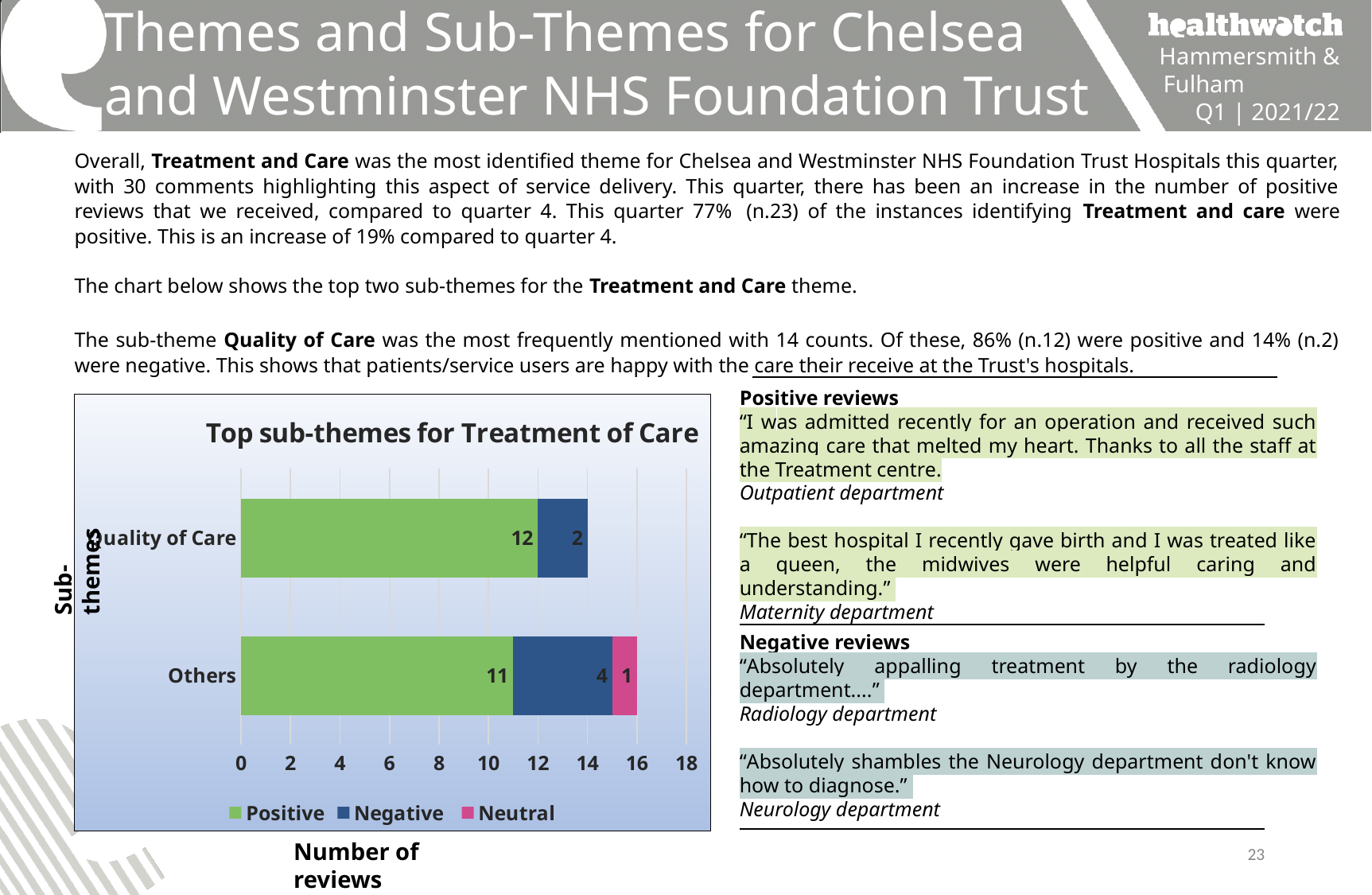
What is the Positive value for Quality of Care? 12 What is the Negative value for Quality of Care? 2 What is the total of the stacked bar for Others? 16 What is the Neutral value for Others? 1 Which category has the larger Positive value, Quality of Care or Others? Quality of Care What is the Negative value for Others? 4 What type of chart is shown on the slide? bar chart What is the difference between the Negative values for Others and Quality of Care? 2 How many series does the chart legend list? 3 What is the total of the stacked bar for Quality of Care? 14 What is the title of the chart? Top sub-themes for Treatment of Care How many sub-theme categories are plotted in the chart? 2